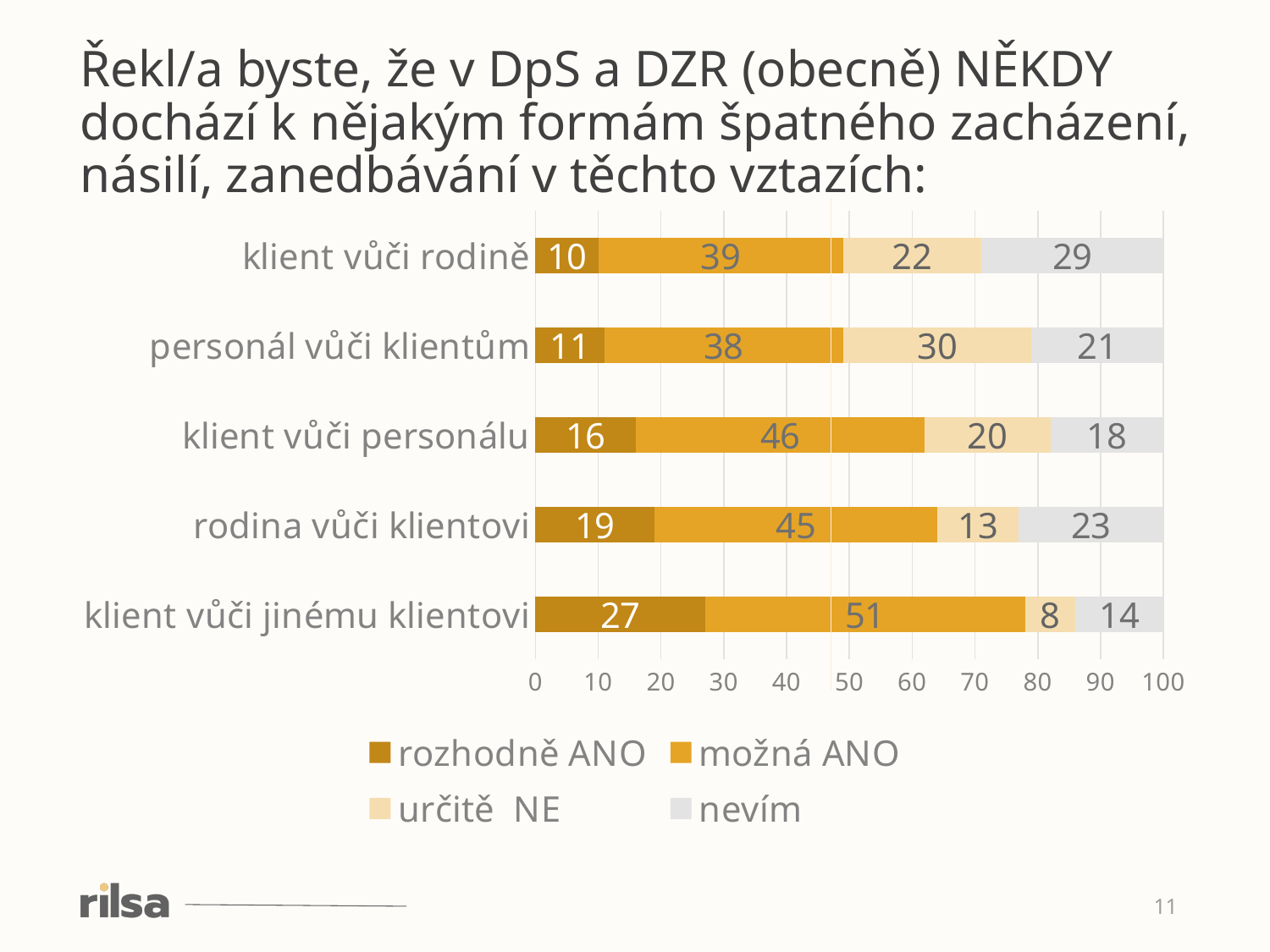
Which is larger: the "nevím" value for "rodina vůči klientovi" or for "klient vůči personálu"? rodina vůči klientovi What is the value of "nevím" for "klient vůči rodině"? 29 What kind of chart is shown on the slide? stacked bar chart How many series does the legend list? 4 What is the difference between the "možná ANO" values for "klient vůči jinému klientovi" and "klient vůči rodině"? 12 What is the value of "rozhodně ANO" for "klient vůči jinému klientovi"? 27 What is the total of the stacked bar for "rodina vůči klientovi"? 100 Which category has the highest value for "rozhodně ANO"? klient vůči jinému klientovi Which category has the lowest value for "určitě NE"? klient vůči jinému klientovi How many categories are shown on the chart? 5 What is the value of "určitě NE" for "personál vůči klientům"? 30 What is the value of "možná ANO" for "klient vůči personálu"? 46